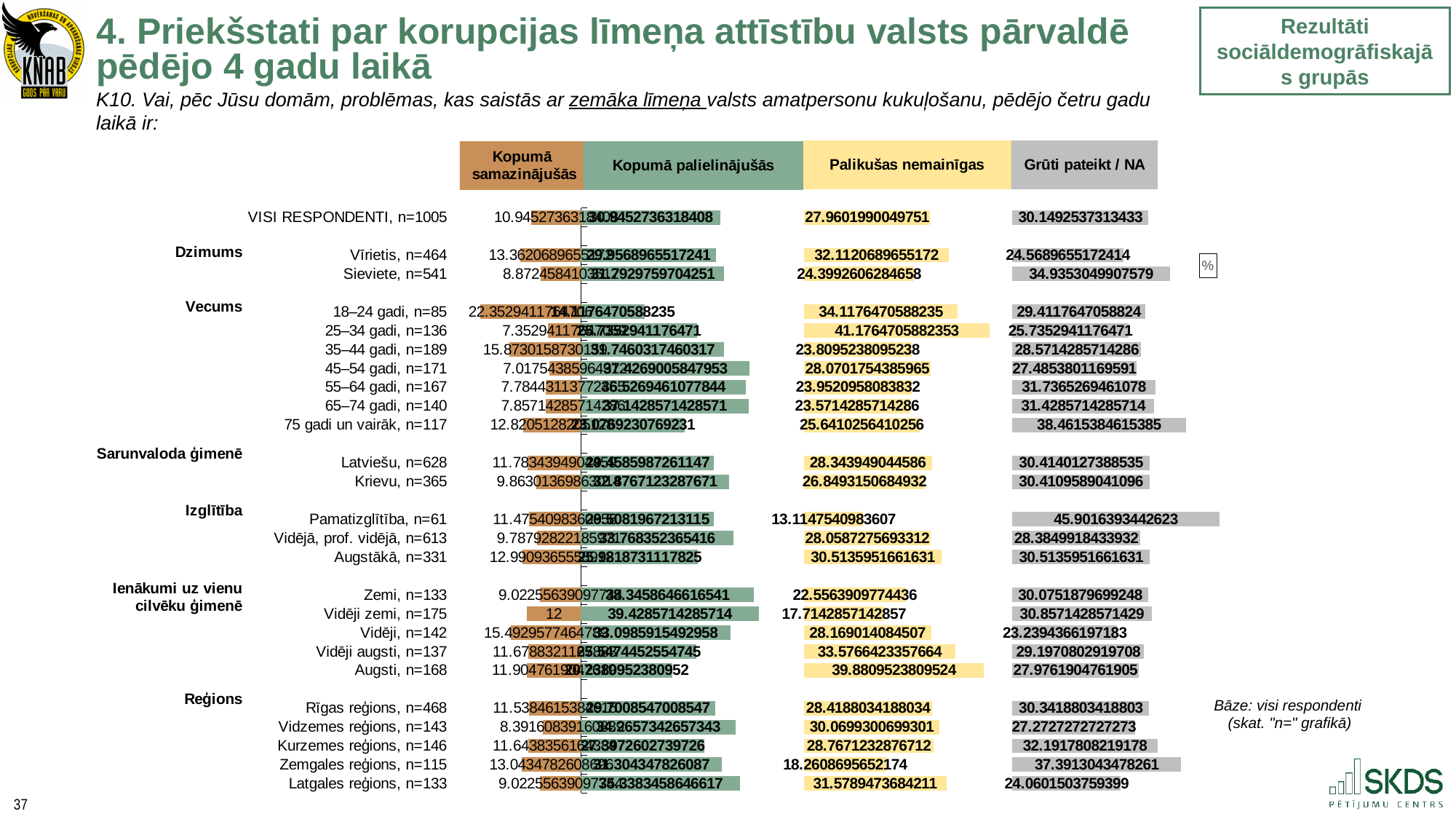
What colour represents the "Palikušas nemainīgas" series? Yellow Which group has the highest value for "Grūti pateikt / NA"? Pamatizglītība, n=61 How many series does the chart legend list? 4 What is the value of "Grūti pateikt / NA" for Sieviete, n=541? 34.9353049907579 Which has the larger "Palikušas nemainīgas" value, Vīrietis, n=464 or Sieviete, n=541? Vīrietis, n=464 How many regions are listed under Reģions? 5 What is the value of "Kopumā samazinājušās" for Vidēji zemi, n=175? 12 Which group has the lowest value for "Palikušas nemainīgas"? Pamatizglītība, n=61 Which group has the highest value for "Palikušas nemainīgas"? 25–34 gadi, n=136 What kind of chart is shown on the slide? Stacked bar chart What is the value of "Palikušas nemainīgas" for VISI RESPONDENTI, n=1005? 27.9601990049751 What is the value of "Kopumā palielinājušās" for Vidēji zemi, n=175? 39.4285714285714